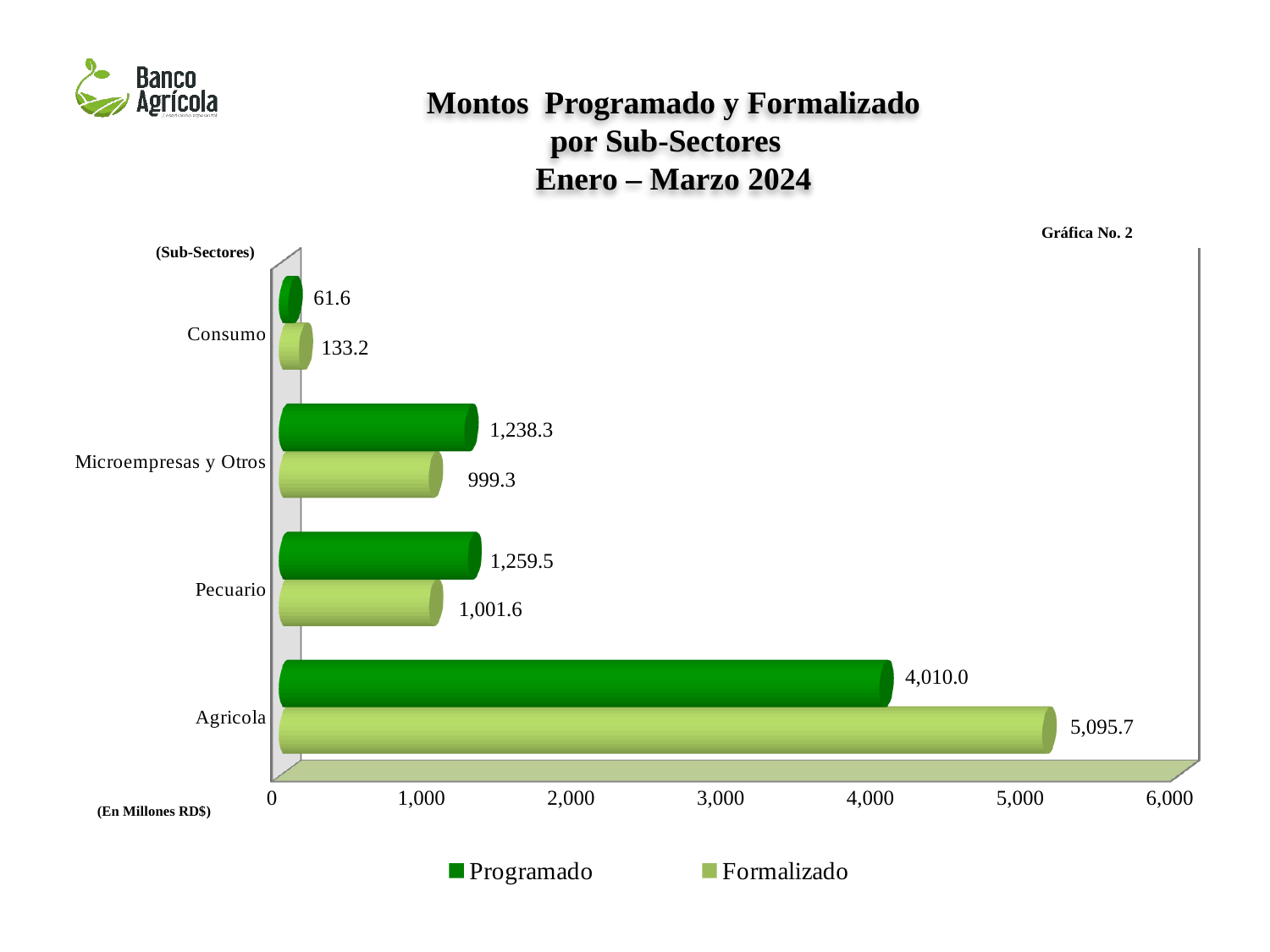
What is the Formalizado value for Pecuario? 1,001.6 What is the Programado value for Microempresas y Otros? 1,238.3 What kind of chart is shown on the slide? Bar chart Which sub-sector has the lowest Programado value? Consumo What is the Formalizado value for Consumo? 133.2 What is the difference between the Formalizado and Programado values for Agricola? 1,085.7 For Pecuario, which is larger: the Programado value or the Formalizado value? Programado Is the Formalizado value for Agricola greater or less than 5,000? greater What is the Programado value for Agricola? 4,010.0 How many series does the legend list? 2 How many sub-sectors are shown on the chart? 4 Which sub-sector has the highest Formalizado value? Agricola